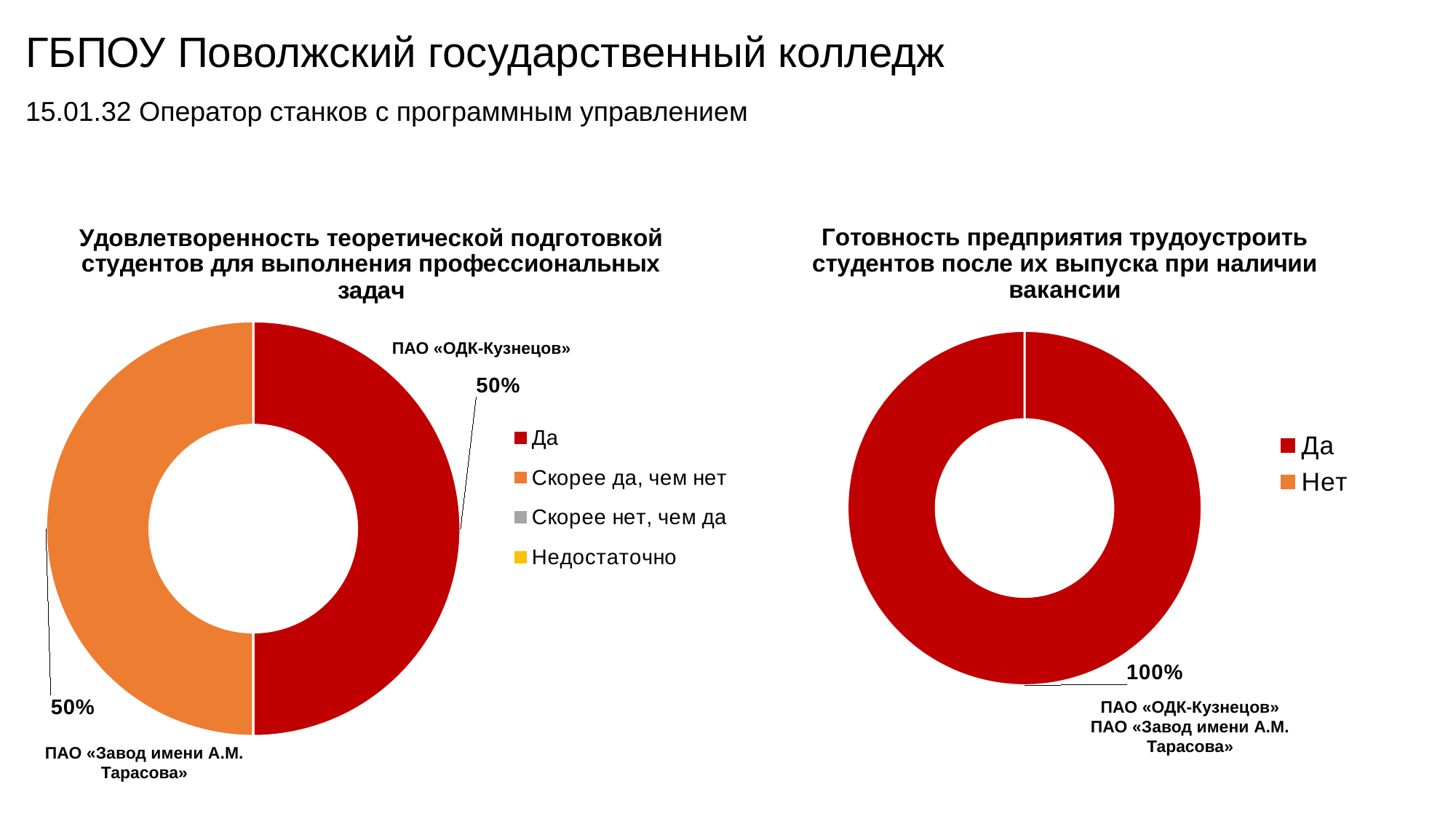
In the left chart («Удовлетворенность теоретической подготовкой...»), which enterprise is associated with the «Да» slice? ПАО «ОДК-Кузнецов» What kind of chart is the left chart, titled «Удовлетворенность теоретической подготовкой студентов для выполнения профессиональных задач»? Doughnut (pie) chart In the right chart («Готовность предприятия трудоустроить студентов...»), what colour is the «Нет» legend entry? Orange What kind of chart is the right chart, titled «Готовность предприятия трудоустроить студентов после их выпуска при наличии вакансии»? Doughnut (pie) chart How many entries does the legend of the left chart («Удовлетворенность теоретической подготовкой...») list? 4 In the left chart («Удовлетворенность теоретической подготовкой...»), what share is labelled for the «Да» slice (ПАО «ОДК-Кузнецов»)? 50% In the left chart («Удовлетворенность теоретической подготовкой...»), how many slices are actually plotted with a visible share? 2 In the left chart («Удовлетворенность теоретической подготовкой...»), what share is labelled for the «Скорее да, чем нет» slice (ПАО «Завод имени А.М. Тарасова»)? 50% In the right chart («Готовность предприятия трудоустроить студентов...»), what share is labelled for the «Да» slice? 100% How many entries does the legend of the right chart («Готовность предприятия трудоустроить студентов...») list? 2 In the left chart («Удовлетворенность теоретической подготовкой...»), what is the difference between the «Да» share and the «Скорее да, чем нет» share? 0% In the right chart («Готовность предприятия трудоустроить студентов...»), which legend category takes up the whole ring? Да